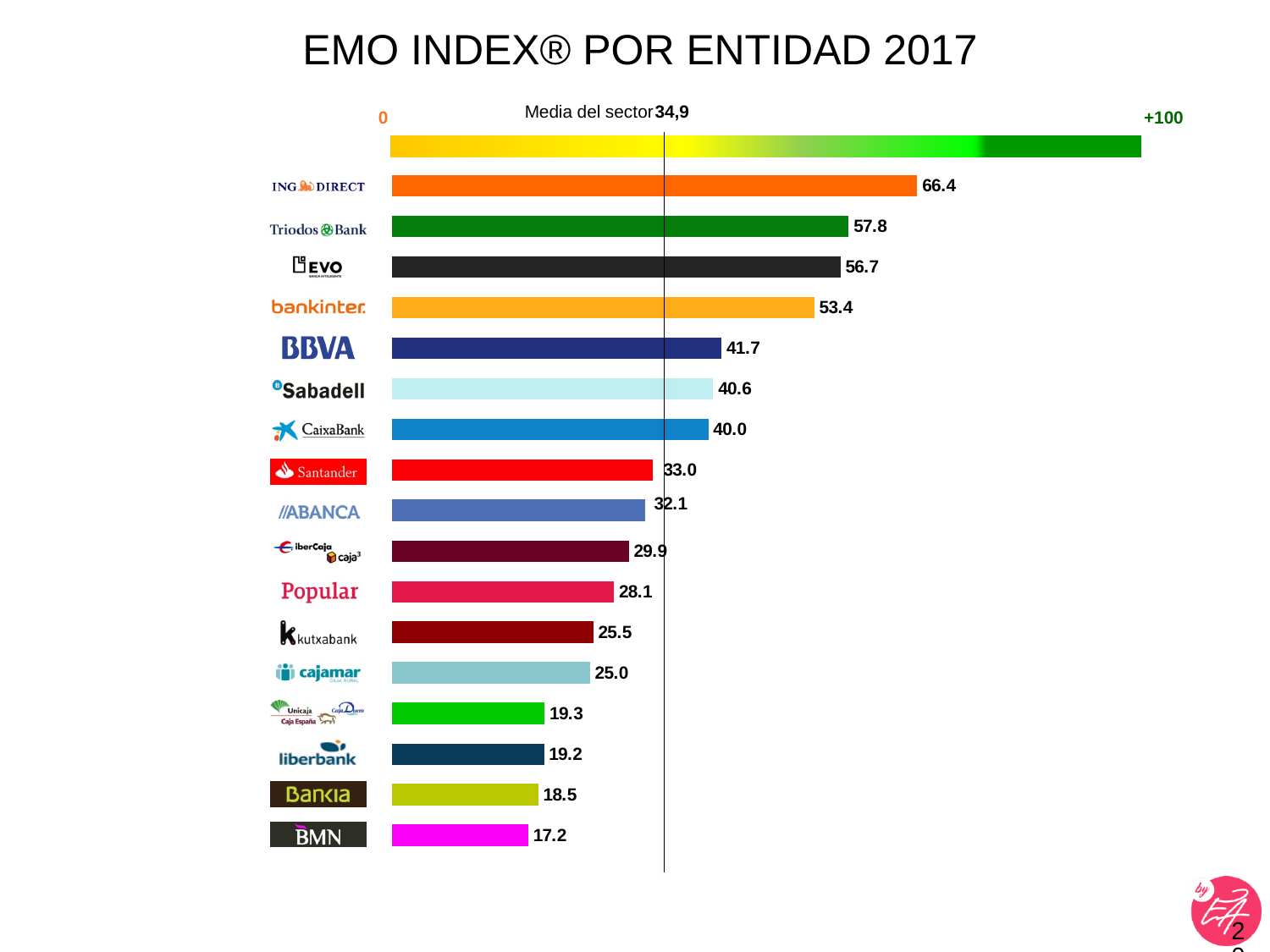
How many entities are shown in the chart? 17 Which entity has the highest EMO Index value? ING Direct Which entity has the lowest EMO Index value? BMN What is the EMO Index value for Bankia? 18.5 Which has a higher EMO Index value, Popular or Kutxabank? Popular What is the sector average (Media del sector) shown on the chart? 34,9 What is the EMO Index value for ING Direct? 66.4 What is the difference between the EMO Index values of ING Direct and BMN? 49.2 What is the EMO Index value for Santander? 33.0 Which has a higher EMO Index value, BBVA or CaixaBank? BBVA What is the difference between the EMO Index values of Triodos Bank and EVO? 1.1 What kind of chart is shown on the slide? Bar chart